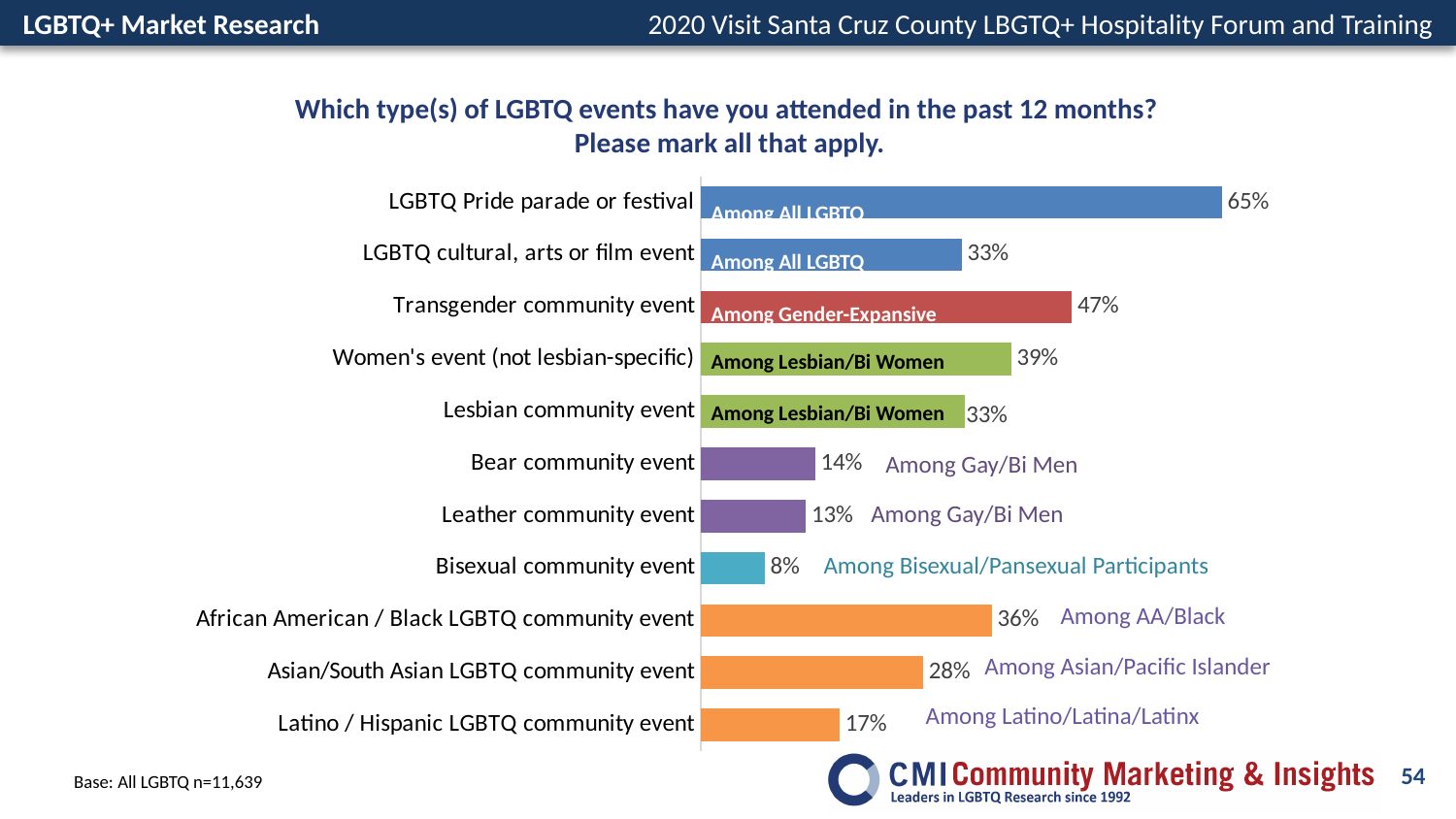
Which group is the Transgender community event bar measured among, according to its label? Among Gender-Expansive Which is larger: the value for Bear community event or Leather community event? Bear community event What is the difference between African American / Black LGBTQ community event and Latino / Hispanic LGBTQ community event? 19% What type of chart is shown on the slide? Bar chart How many event types are shown in the chart? 11 What is the value for Transgender community event? 47% What percentage attended a Bisexual community event? 8% What is the difference between the values for Women's event (not lesbian-specific) and Lesbian community event? 6% What percentage attended an LGBTQ Pride parade or festival in the past 12 months? 65% Which event type has the highest percentage? LGBTQ Pride parade or festival What is the value for Asian/South Asian LGBTQ community event? 28% Which event type has the lowest percentage? Bisexual community event